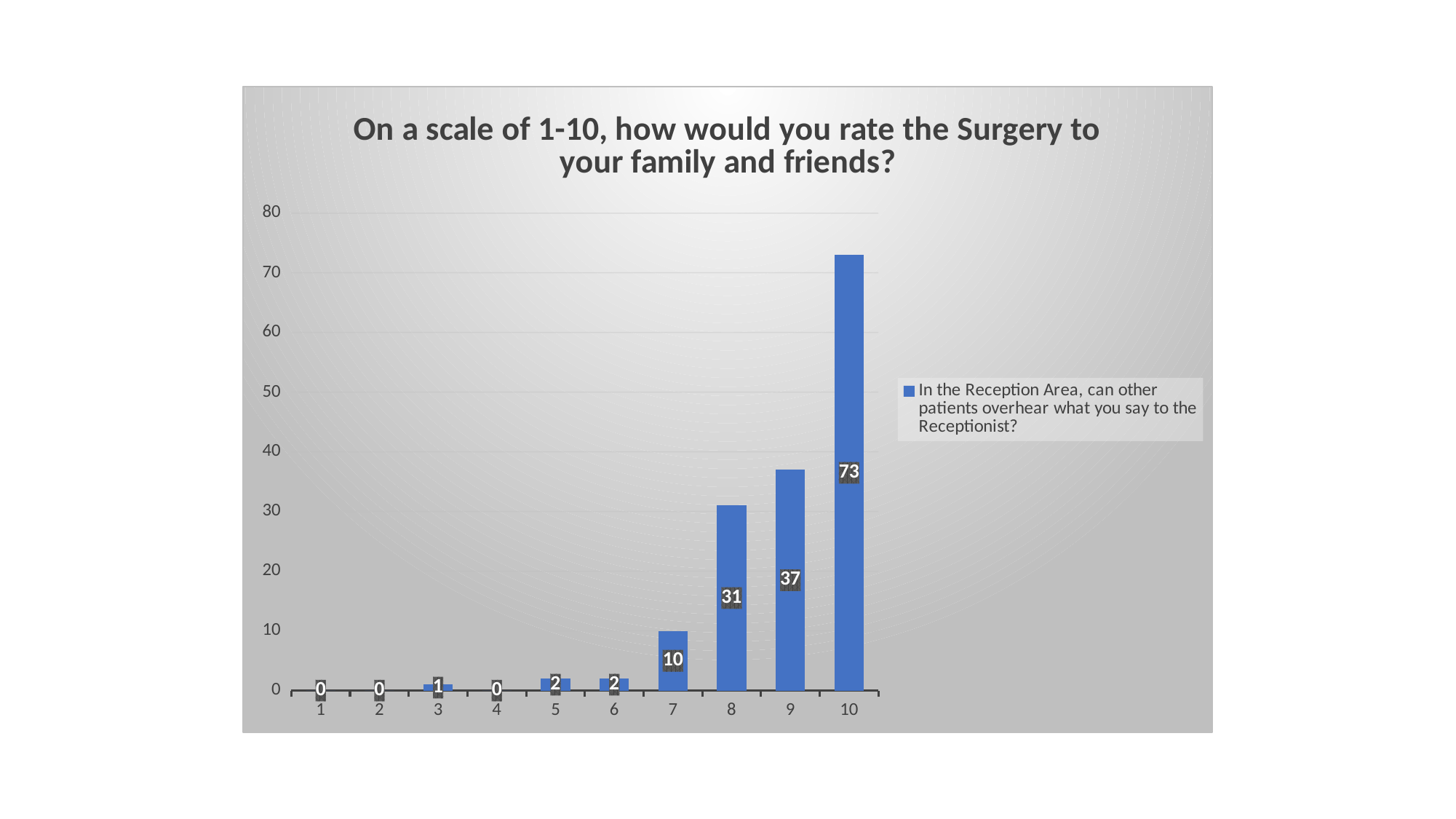
What is the difference between the values for rating 10 and rating 9? 36 Which is larger, the value for rating 8 or the value for rating 9? rating 9 How many rating categories are shown on the x axis? 10 Which rating has the highest value? 10 How many series does the legend list? 1 What is the title of the chart? On a scale of 1-10, how would you rate the Surgery to your family and friends? Do the values generally rise or fall from rating 1 to rating 10? rise Is the value for rating 10 greater or less than 70? greater What kind of chart is shown? bar chart What is the value for rating 10? 73 What is the value for rating 7? 10 What is the value for rating 8? 31